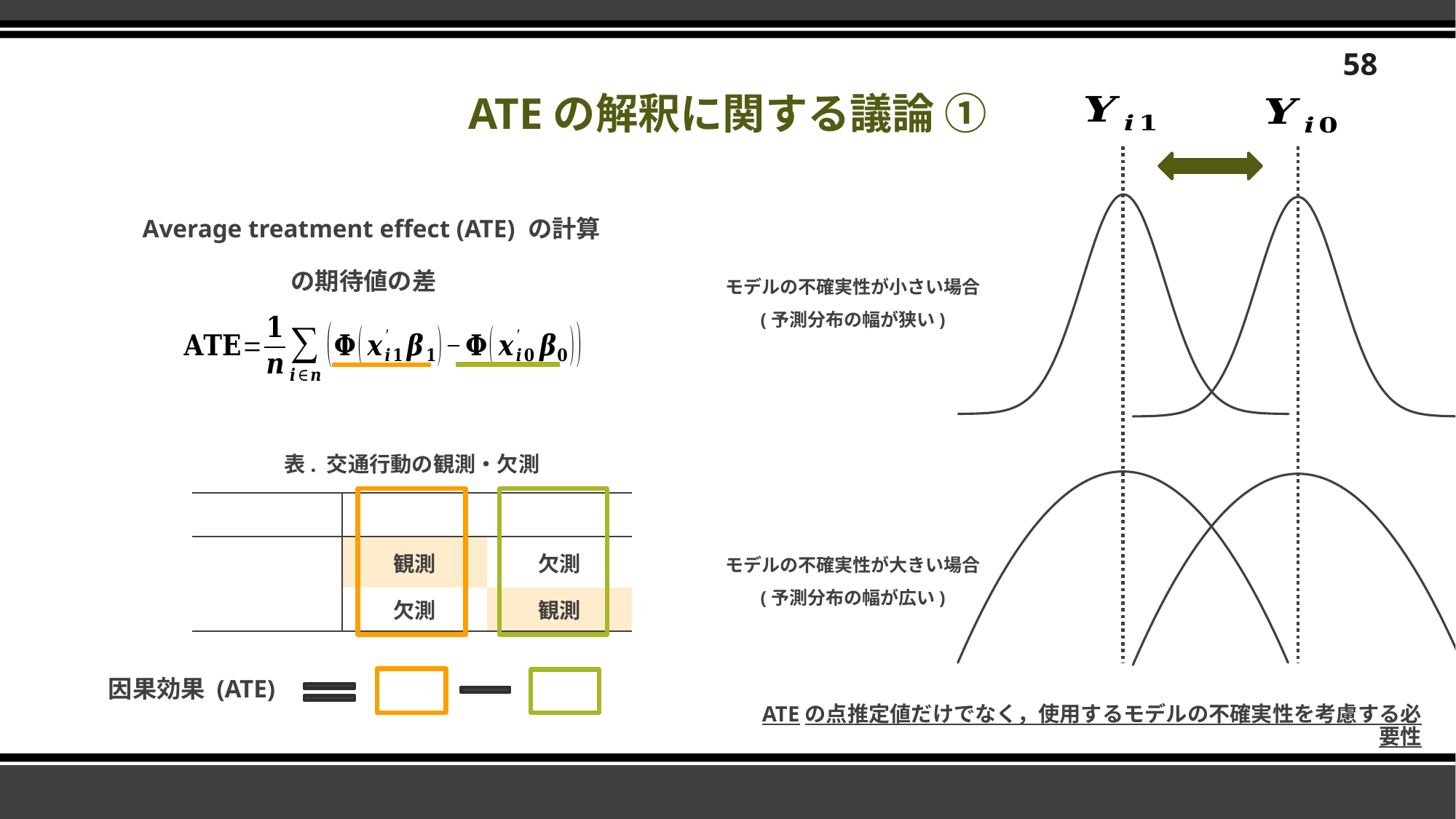
What are the labels of the two distributions shown in the diagrams on the right? Y_i1 and Y_i0 Which distribution label, Y_i1 or Y_i0, is positioned on the left in the diagrams on the right? Y_i1 In the top diagram on the right, how many distribution curves are drawn? 2 In the bottom diagram on the right, how many distribution curves are drawn? 2 Which of the two diagrams on the right, top or bottom, shows the wider (more uncertain) prediction distributions? bottom